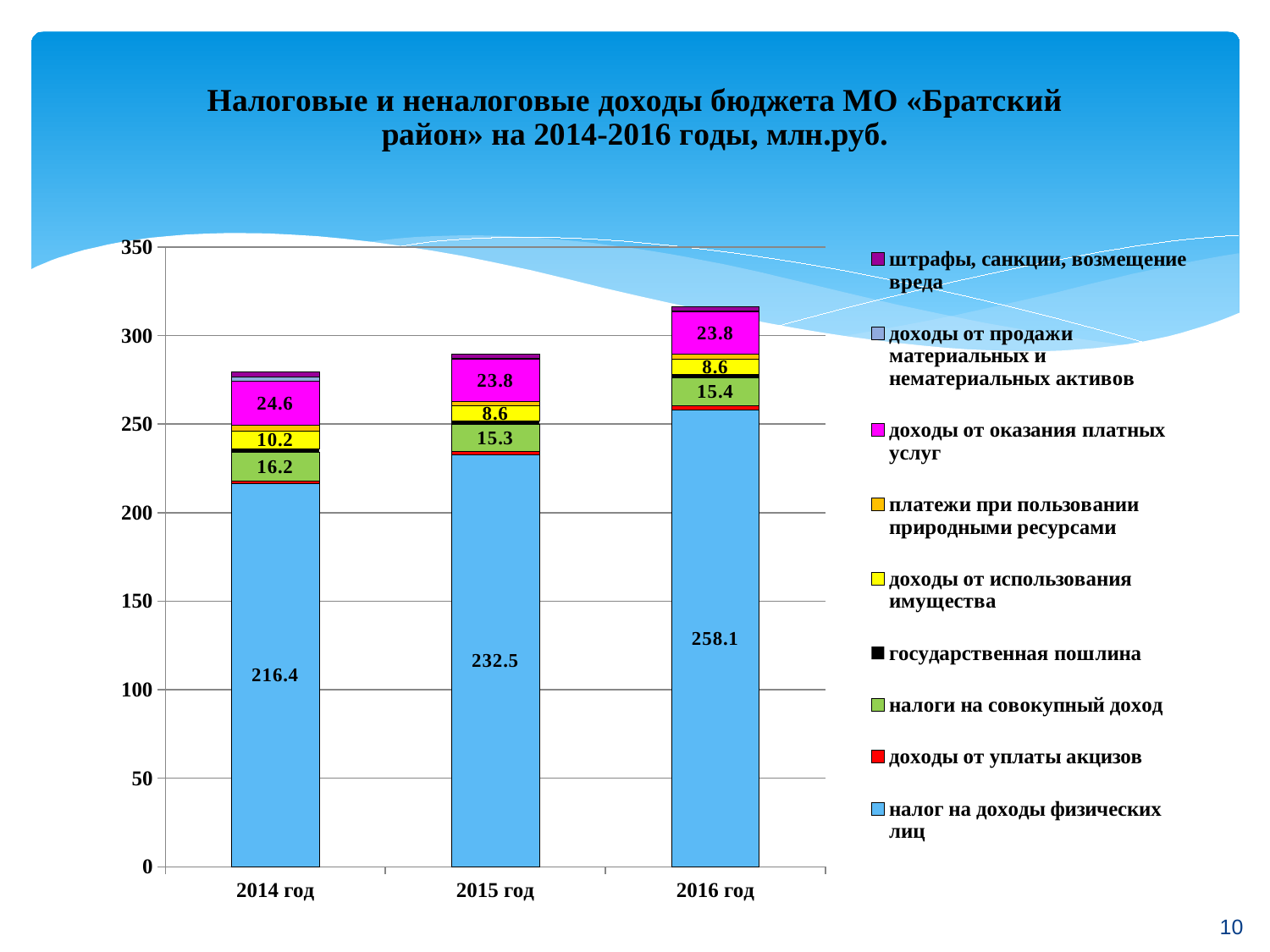
Which year has the lowest value for доходы от оказания платных услуг? 2015 год and 2016 год (both 23.8) How many series does the legend list? 9 What is the difference in налог на доходы физических лиц between 2016 год and 2014 год? 41.7 What is the value of налог на доходы физических лиц for 2016 год? 258.1 Which is larger: доходы от использования имущества in 2014 год or in 2015 год? 2014 год Which year has the highest value for налог на доходы физических лиц? 2016 год What is the value of налог на доходы физических лиц for 2014 год? 216.4 Is the total height of the 2016 год bar greater or less than 300? greater What is the value of налоги на совокупный доход for 2014 год? 16.2 What is the value of доходы от оказания платных услуг for 2015 год? 23.8 What is the value of доходы от использования имущества for 2016 год? 8.6 What kind of chart is shown on the slide? Stacked bar chart